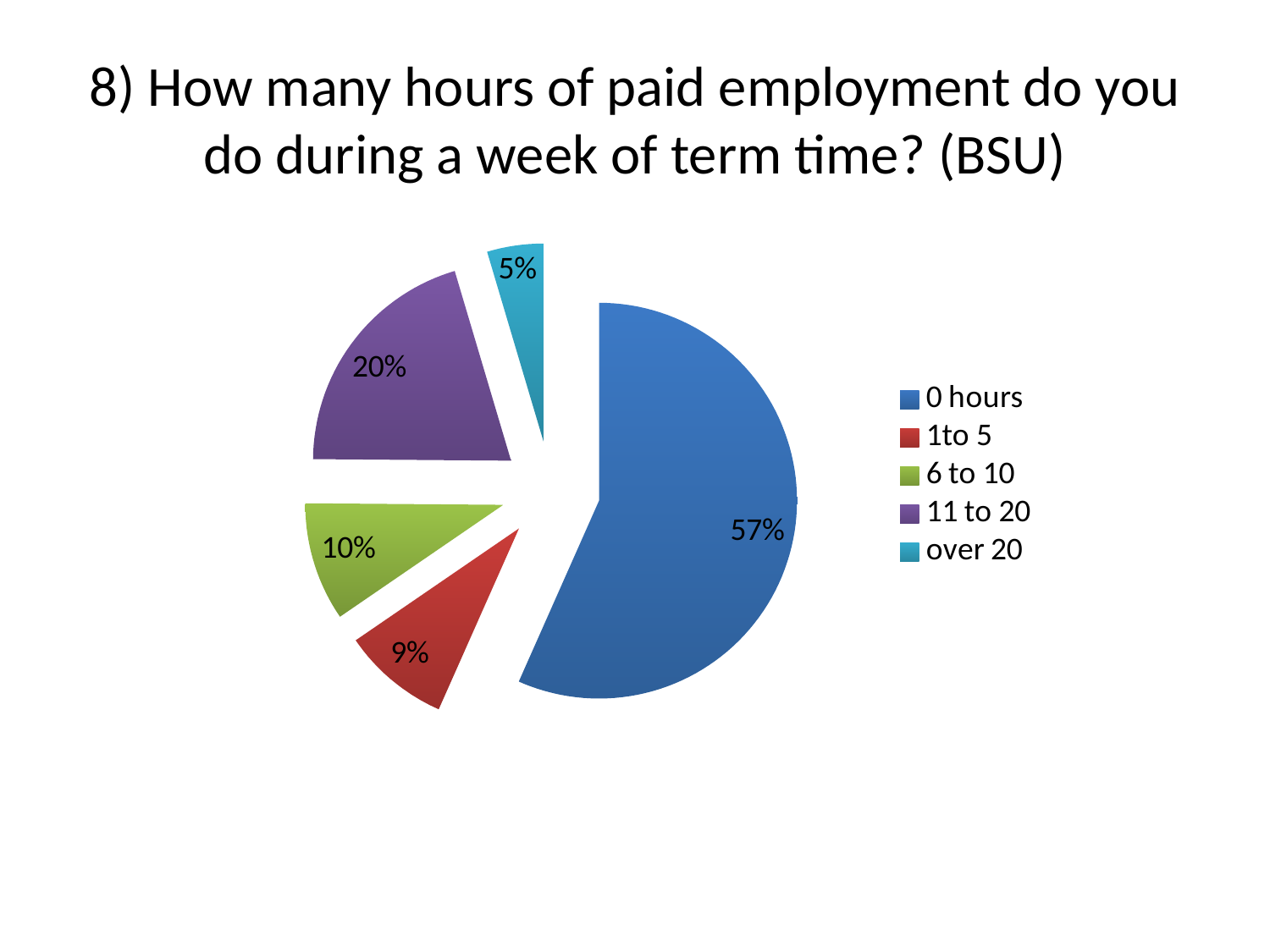
What share of the pie is the '11 to 20' slice? 20% What kind of chart is shown on the slide? pie chart How many categories does the legend list? 5 What colour is the '11 to 20' slice? purple Which slice is larger, '6 to 10' or '1to 5'? 6 to 10 Which category has the smallest slice of the pie? over 20 What share of the pie is the 'over 20' slice? 5% Which category has the largest slice of the pie? 0 hours What is the difference in percentage points between the '0 hours' slice and the '11 to 20' slice? 37 What share of the pie is the '1to 5' slice? 9%